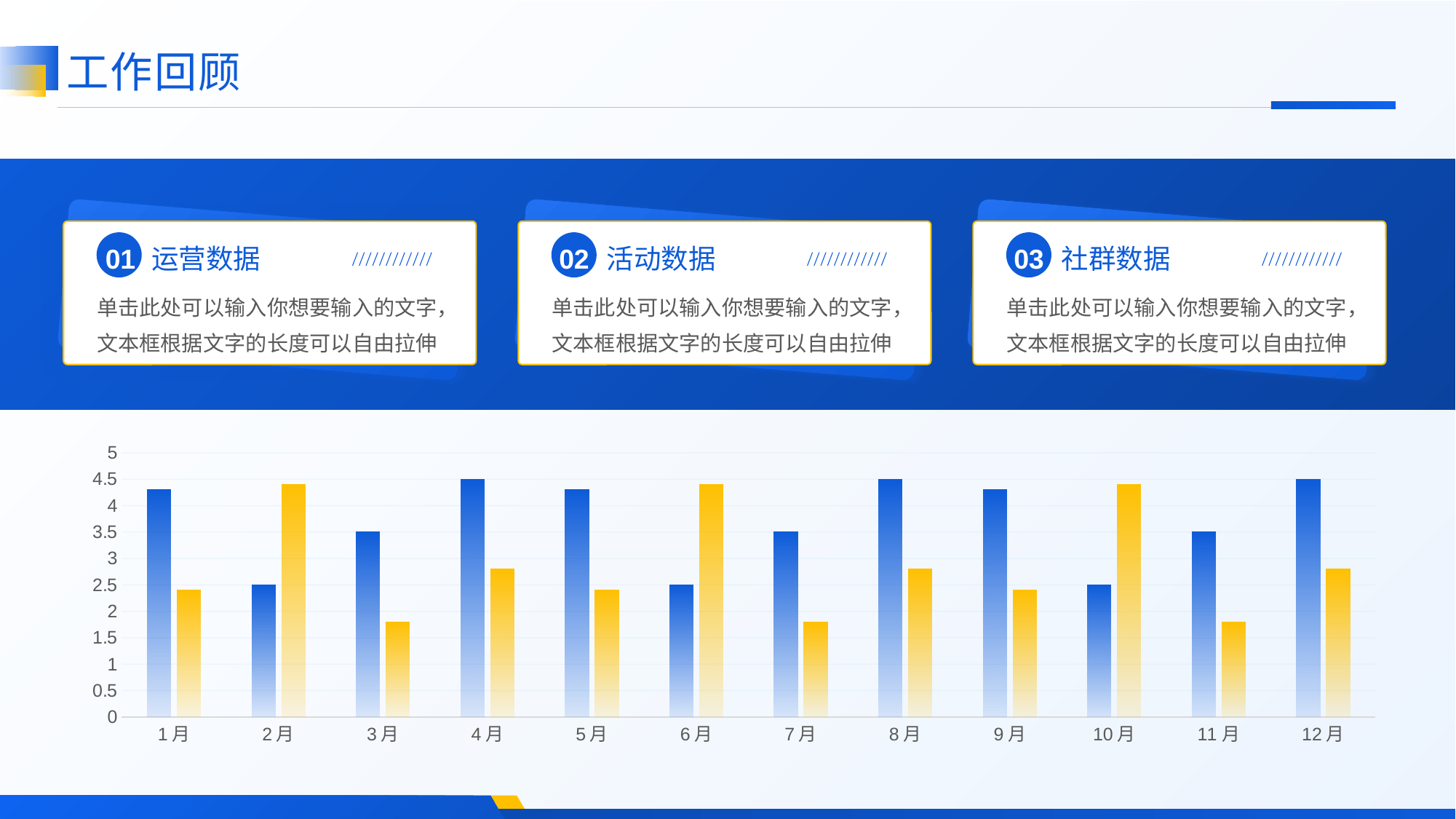
How many bars are plotted for each month in the chart? 2 For 6月, which bar is taller, the blue bar or the yellow bar? the yellow bar What kind of chart is shown on the slide? bar chart How many months are shown on the x axis of the chart? 12 What value does the blue bar for 4月 reach on the axis? 4.5 What value does the blue bar for 3月 reach on the axis? 3.5 For 1月, which bar is taller, the blue bar or the yellow bar? the blue bar Is the value of the yellow bar for 3月 greater or less than 2? less Is the value of the yellow bar for 4月 greater or less than 2.5? greater Is the value of the yellow bar for 2月 greater or less than 4? greater What value does the blue bar for 2月 reach on the axis? 2.5